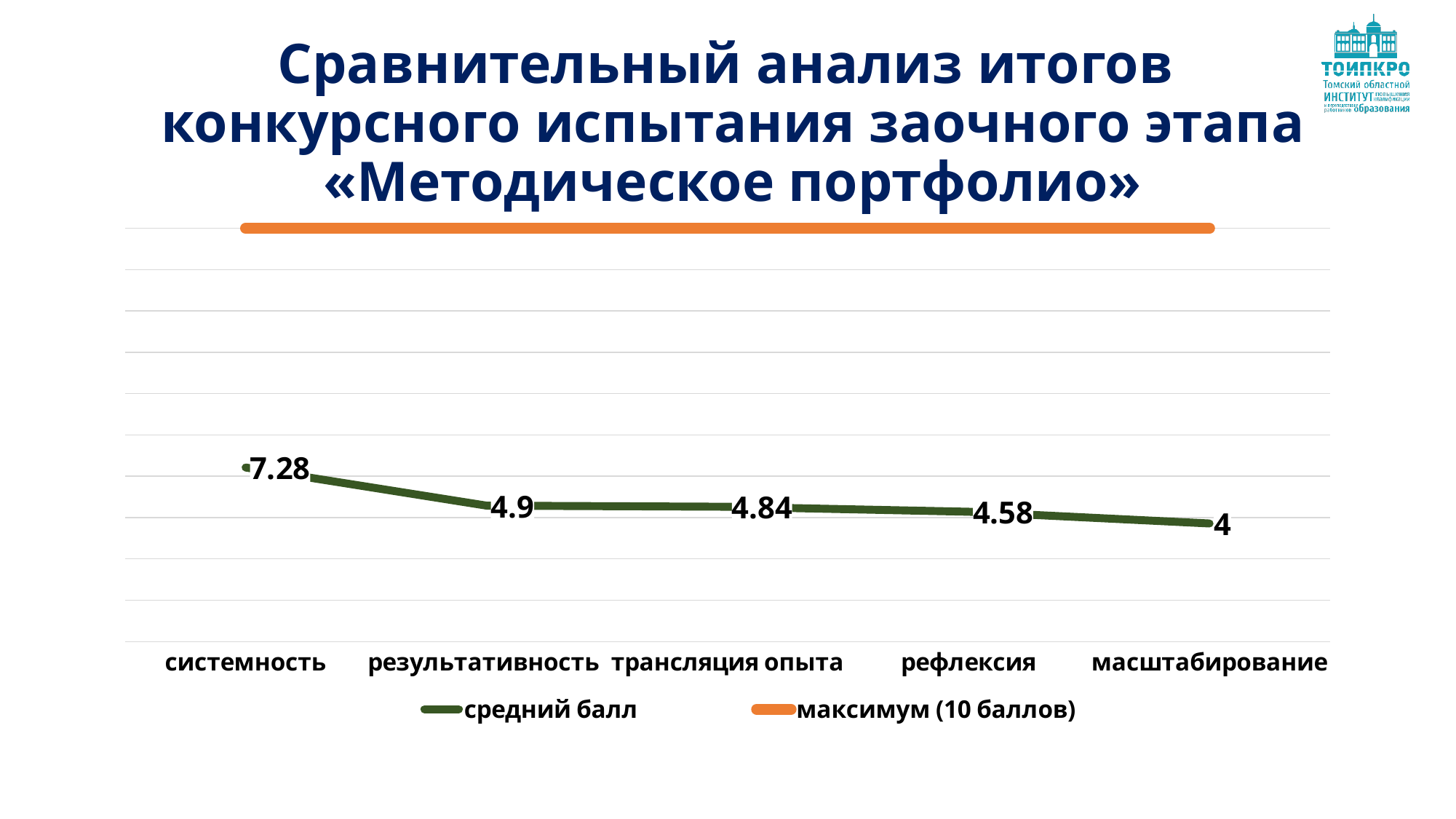
Which has a larger average score, результативность or рефлексия? результативность How many series does the legend list? 2 What is the average score (средний балл) for масштабирование? 4 Which category has the lowest average score? масштабирование What is the average score (средний балл) for результативность? 4.9 How many categories are shown on the x axis? 5 What is the average score (средний балл) for трансляция опыта? 4.84 What is the average score (средний балл) for системность? 7.28 What is the difference between the average scores for системность and масштабирование? 3.28 What is the average score (средний балл) for рефлексия? 4.58 Does the average score rise or fall from системность to масштабирование? fall Which category has the highest average score? системность